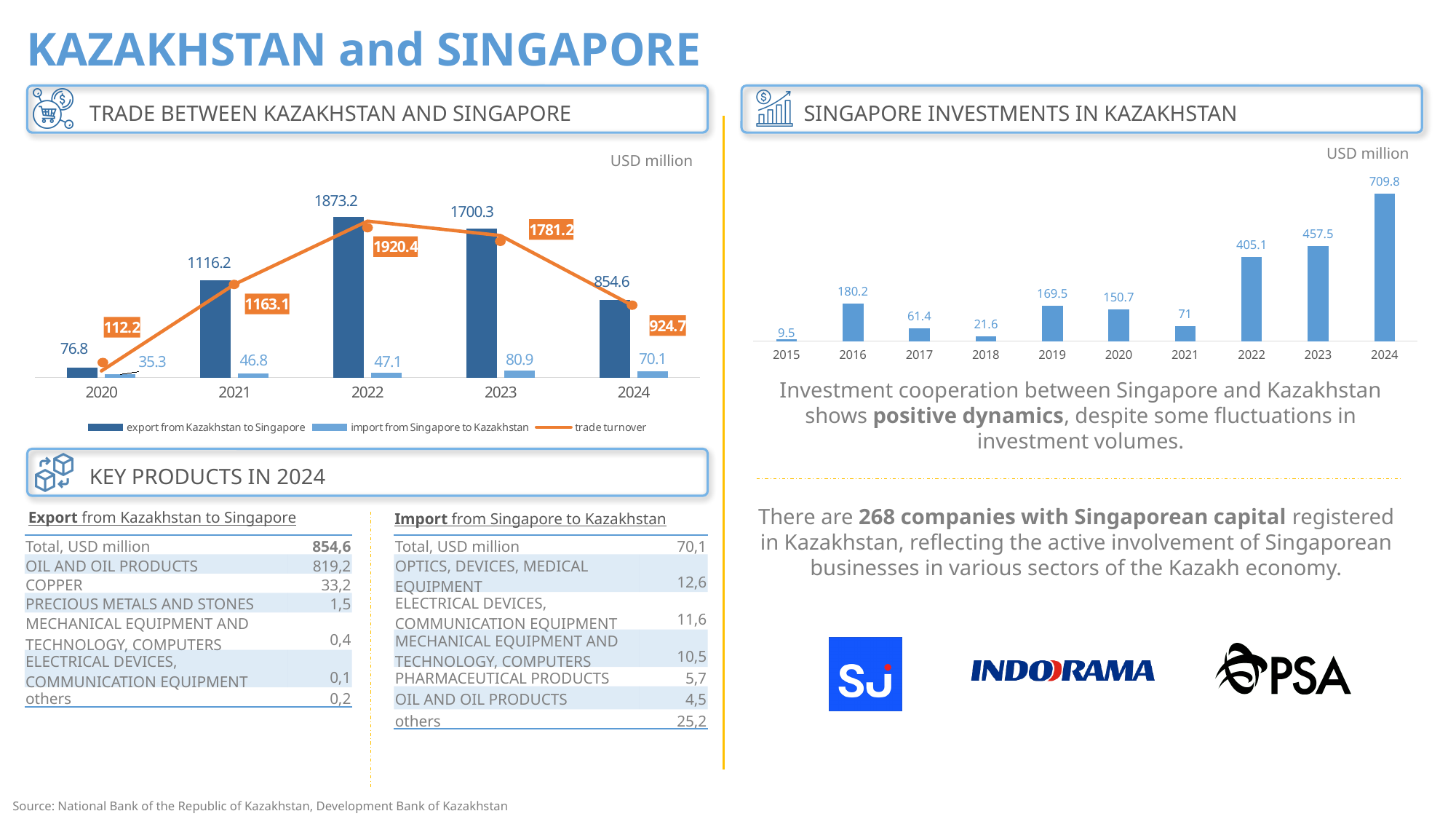
What kind of chart is the 'Singapore investments in Kazakhstan' chart? bar chart In the 'Trade between Kazakhstan and Singapore' chart, which year had the highest trade turnover? 2022 In the 'Trade between Kazakhstan and Singapore' chart, what was the export from Kazakhstan to Singapore in 2022? 1873.2 In the 'Trade between Kazakhstan and Singapore' chart, what was the trade turnover in 2021? 1163.1 In the 'Trade between Kazakhstan and Singapore' chart, how many series does the legend list? 3 In the 'Singapore investments in Kazakhstan' chart, what is the difference between the 2024 and 2023 values? 252.3 In the 'Singapore investments in Kazakhstan' chart, how many years are shown? 10 In the 'Singapore investments in Kazakhstan' chart, which year had the lowest value? 2015 In the 'Trade between Kazakhstan and Singapore' chart, what was the import from Singapore to Kazakhstan in 2023? 80.9 In the 'Singapore investments in Kazakhstan' chart, what was the value for 2019? 169.5 In the 'Trade between Kazakhstan and Singapore' chart, what is the difference between export and import in 2024? 784.5 In the 'Trade between Kazakhstan and Singapore' chart, did the export from Kazakhstan to Singapore rise or fall from 2022 to 2024? fall